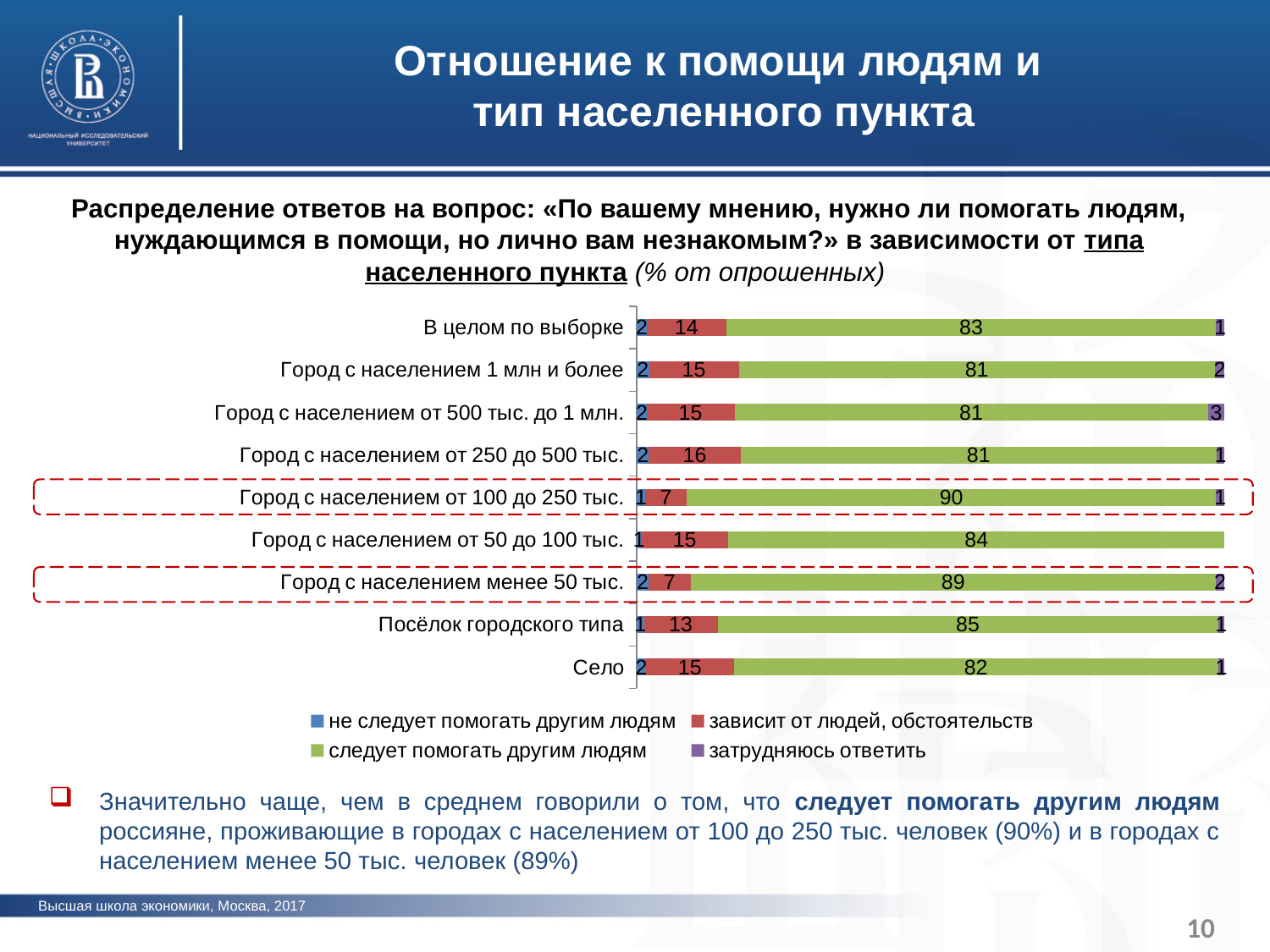
How many categories (types of settlement) are shown on the chart? 9 What is the value for «затрудняюсь ответить» for «Город с населением от 500 тыс. до 1 млн.»? 3 Which has a larger value for «следует помогать другим людям»: «Посёлок городского типа» or «Село»? Посёлок городского типа What is the value for «зависит от людей, обстоятельств» for «Город с населением от 250 до 500 тыс.»? 16 How many series does the legend list? 4 What is the value for «следует помогать другим людям» in the «В целом по выборке» bar? 83 What is the total of the stacked bar for «В целом по выборке»? 100 What is the difference between the «следует помогать другим людям» values for «Город с населением от 100 до 250 тыс.» and «В целом по выборке»? 7 Which category has the highest value for «следует помогать другим людям»? Город с населением от 100 до 250 тыс. What kind of chart is shown on the slide? Stacked bar chart Which category has the highest value for «зависит от людей, обстоятельств»? Город с населением от 250 до 500 тыс. What is the value for «следует помогать другим людям» for «Село»? 82